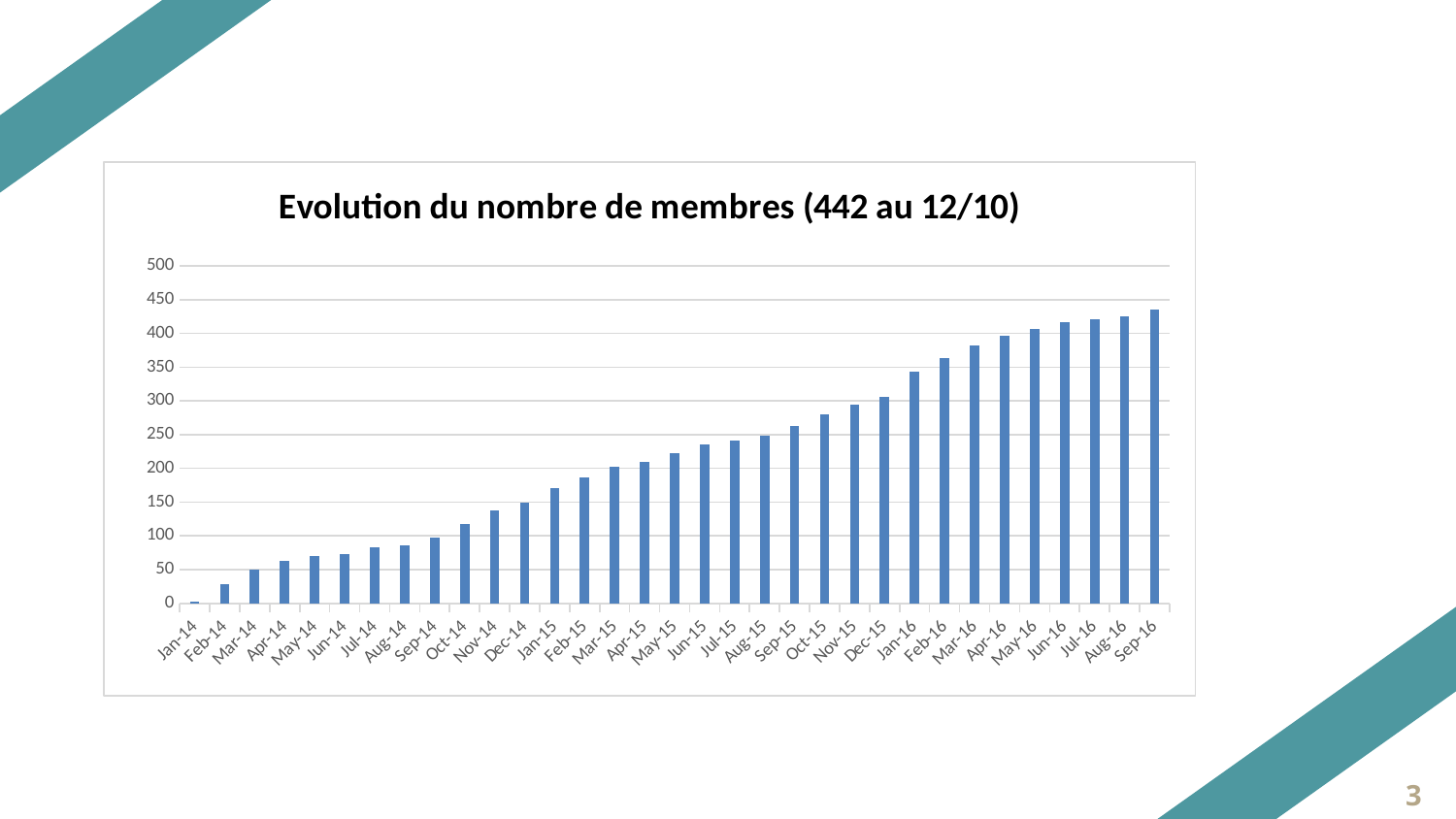
Do the values rise or fall from Jan-14 to Sep-16? rise What kind of chart is shown on the slide? bar chart Is the value for Sep-16 greater or less than 400? greater Which month has the highest number of members? Sep-16 Which month has the lowest number of members? Jan-14 Is the value for Jan-14 greater or less than 50? less Is the value for Oct-14 greater or less than 100? greater Which is larger, the value for Dec-14 or the value for Dec-15? Dec-15 How many months are plotted on the x axis? 33 What is the title of the chart? Evolution du nombre de membres (442 au 12/10)